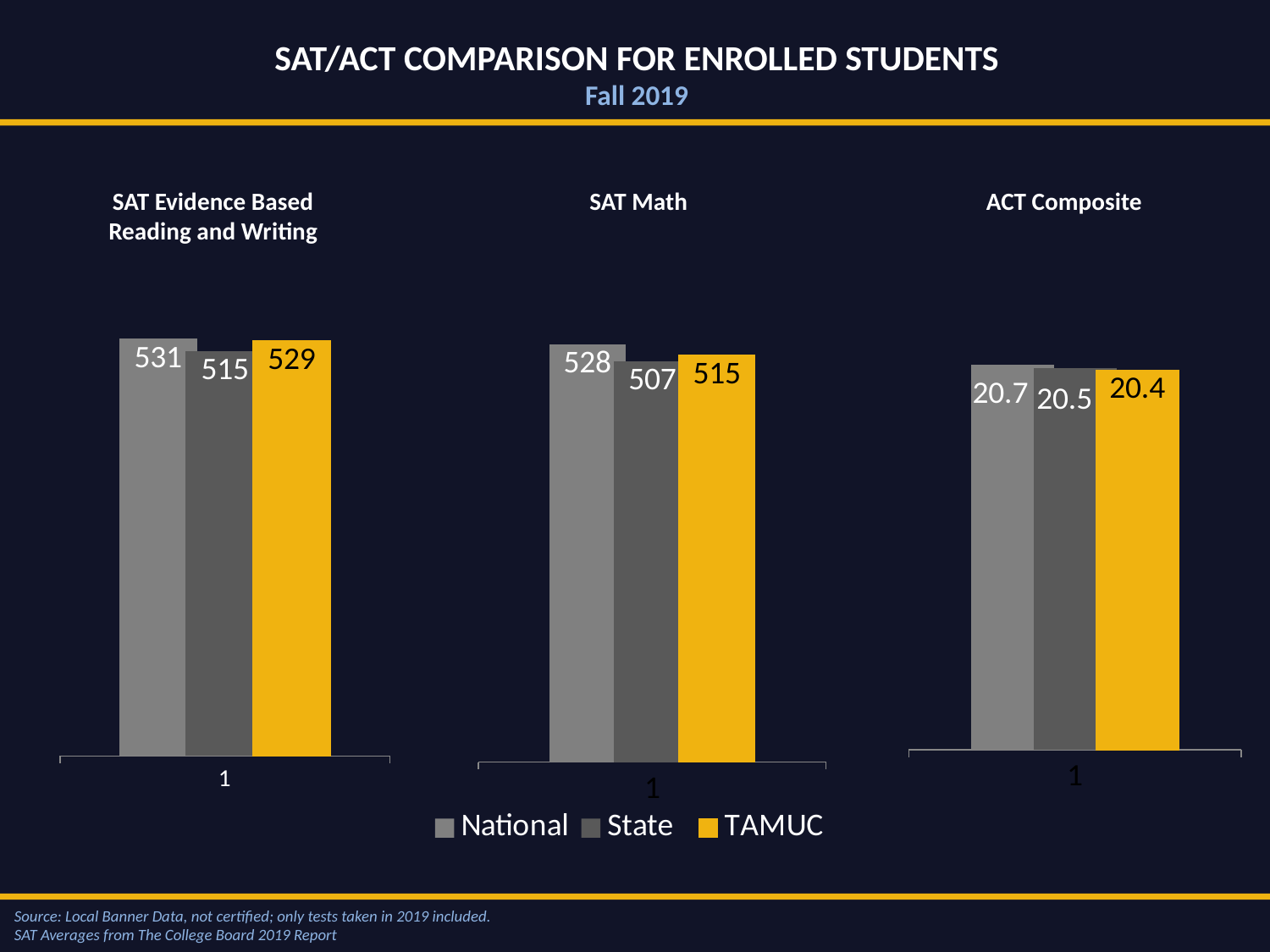
In the SAT Evidence Based Reading and Writing chart, what is the National value? 531 In the SAT Math chart, which series has the highest value? National In the SAT Evidence Based Reading and Writing chart, what is the difference between the TAMUC and State values? 14 What kind of chart is the SAT Math chart? Bar chart In the SAT Math chart, which is larger, the TAMUC value or the State value? TAMUC In the ACT Composite chart, what is the TAMUC value? 20.4 In the ACT Composite chart, which is larger, the National value or the TAMUC value? National In the SAT Math chart, what is the State value? 507 How many series does the legend list? 3 In the SAT Evidence Based Reading and Writing chart, which series has the lowest value? State In the SAT Math chart, what is the difference between the National and State values? 21 What colour are the TAMUC bars in the charts? Yellow